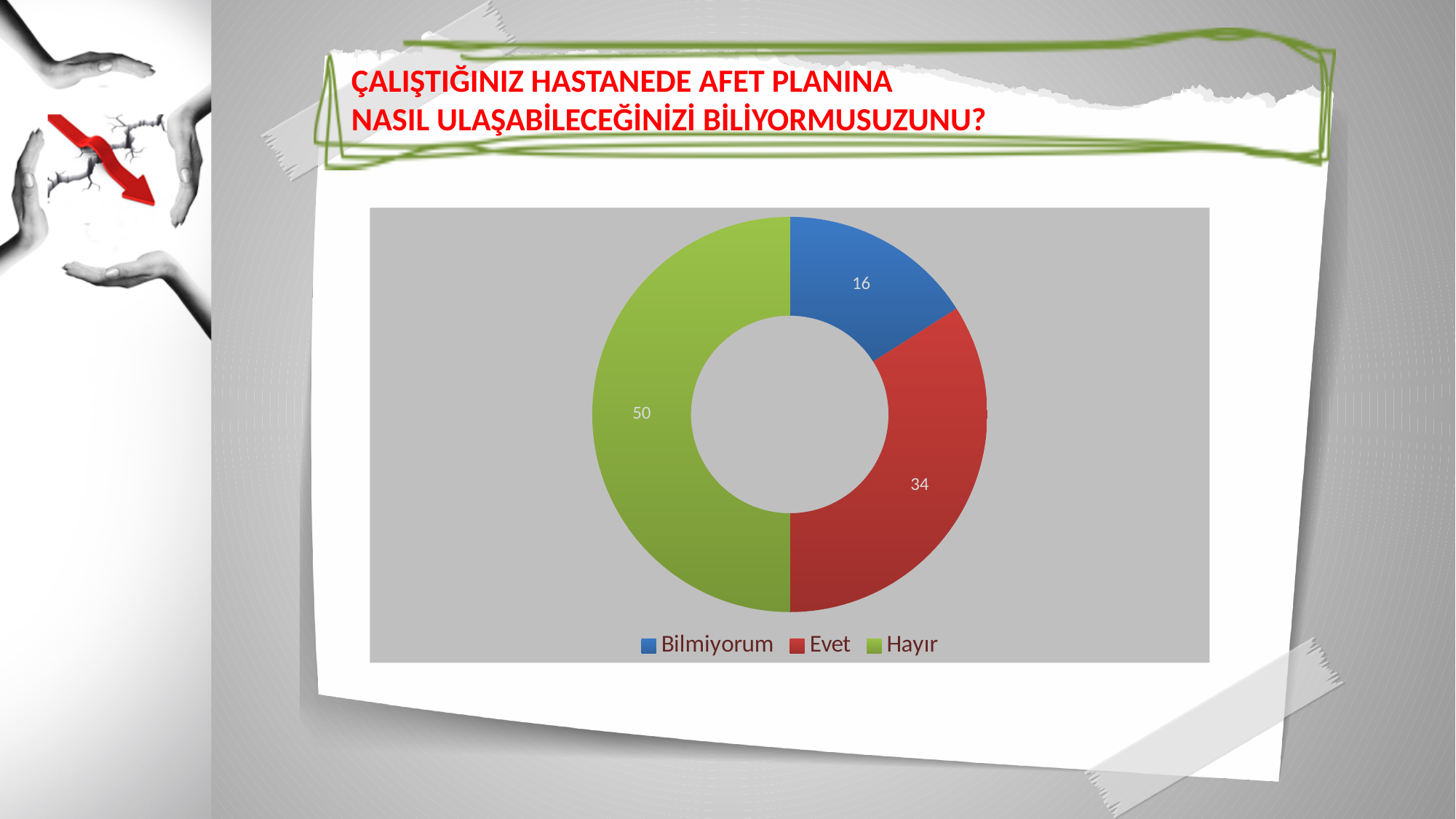
What is the difference between the values for Evet and Bilmiyorum? 18 What share of the total does Hayır represent? 50% How many categories does the chart show? 3 What kind of chart is shown on the slide? Doughnut chart What is the value for Bilmiyorum? 16 Which category has the highest value? Hayır What is the value for Evet? 34 What is the value for Hayır? 50 Which is larger, the value for Evet or the value for Bilmiyorum? Evet What colour is the Evet slice? Red Which category has the lowest value? Bilmiyorum What is the difference between the values for Hayır and Evet? 16